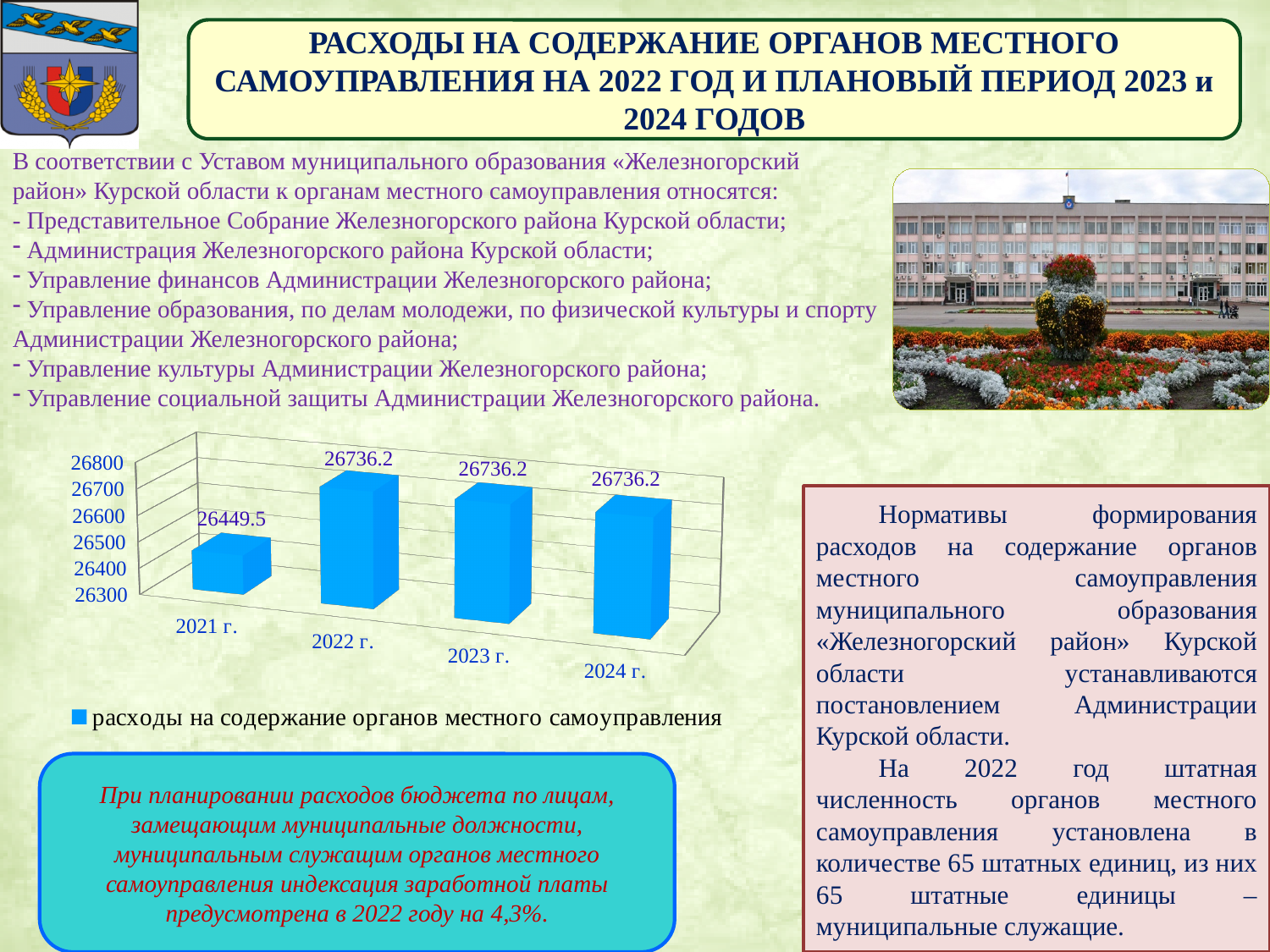
What is the value for 2022 г.? 26736.2 Which is larger, the value for 2021 г. or the value for 2023 г.? 2023 г. What is the value for 2021 г.? 26449.5 What is the value for 2024 г.? 26736.2 What kind of chart is shown on the slide? bar chart What is the legend entry of the chart? расходы на содержание органов местного самоуправления Is the value for 2023 г. greater or less than 26700? greater Which year has the lowest value? 2021 г. Is the value for 2021 г. greater or less than 26500? less What is the difference between the values for 2022 г. and 2021 г.? 286.7 How many years are shown on the chart? 4 How many series does the legend list? 1